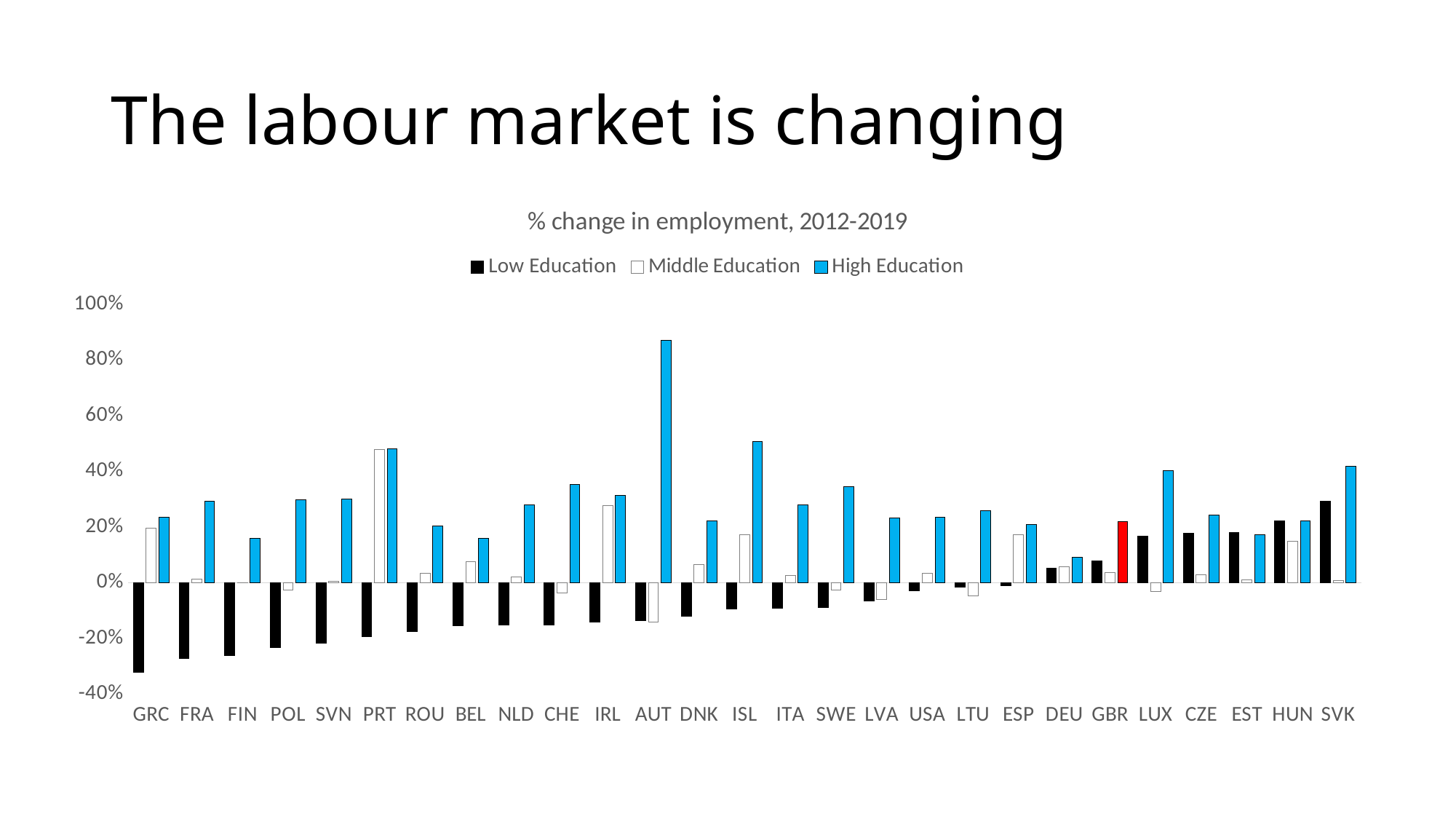
Is the High Education value for ISL greater or less than 40%? greater How many countries are shown on the x axis? 27 Is the High Education value for AUT greater or less than 80%? greater Is the Low Education value for GRC greater or less than -20%? less Do the Low Education values generally rise or fall from left to right along the x axis? rise What is the title of the chart? % change in employment, 2012-2019 Which country has the lowest Low Education value? GRC Which country has the highest Middle Education value? PRT How many series does the legend list? 3 What kind of chart is shown on the slide? bar chart Which country has the highest High Education value? AUT Which is larger, the High Education value for ISL or for DNK? ISL